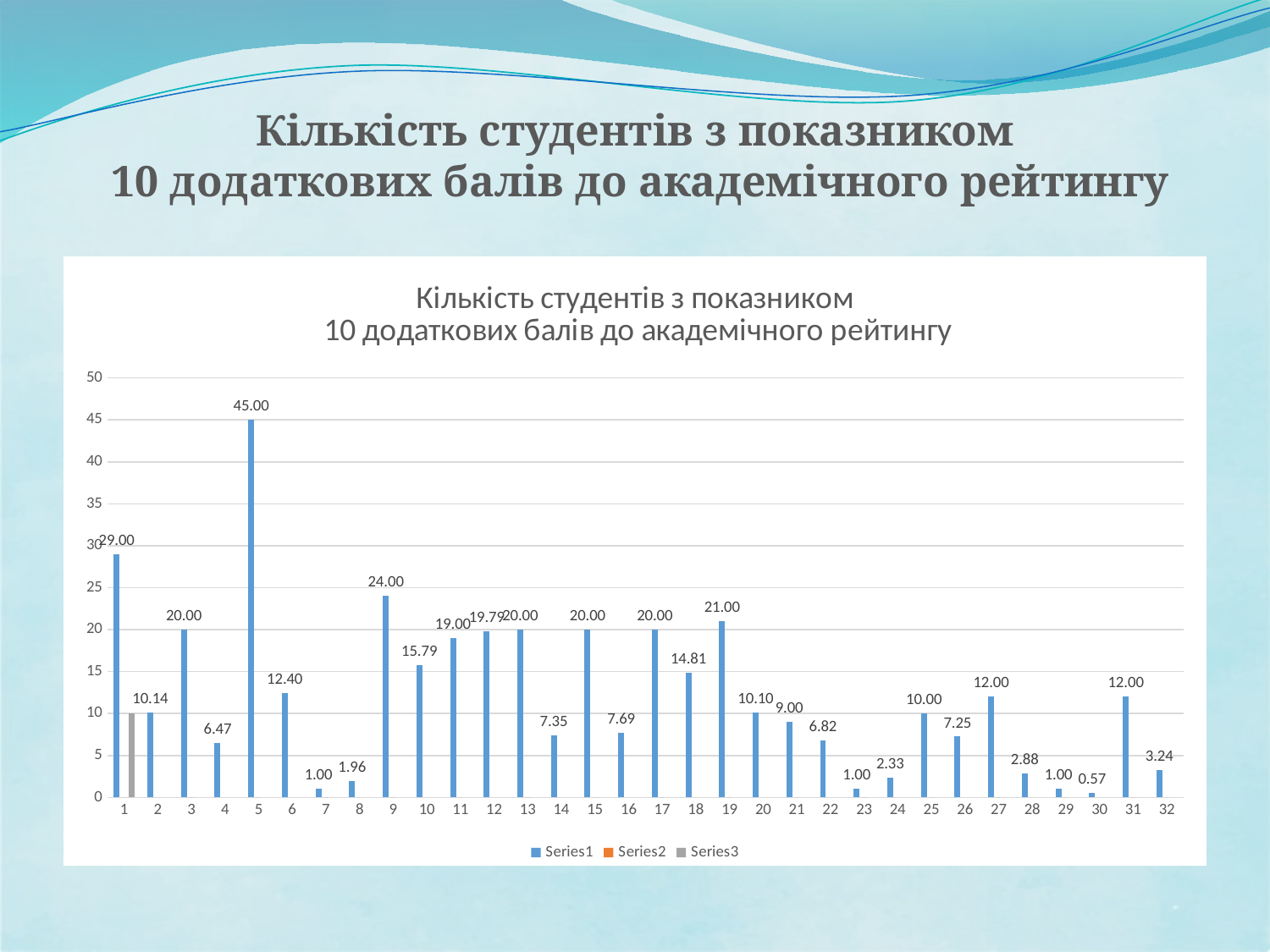
What is the value for category 9? 24.00 What is the value for category 30? 0.57 What is the difference between the values for category 5 and category 9? 21.00 What is the value for category 18? 14.81 What is the value for category 5? 45.00 Which category has the lowest value? 30 Which category has the highest value? 5 Which is larger, the value for category 9 or the value for category 19? category 9 What kind of chart is shown on the slide? bar chart How many series does the legend list? 3 Is the value for category 1 greater or less than 25? greater How many categories are shown on the x axis? 32